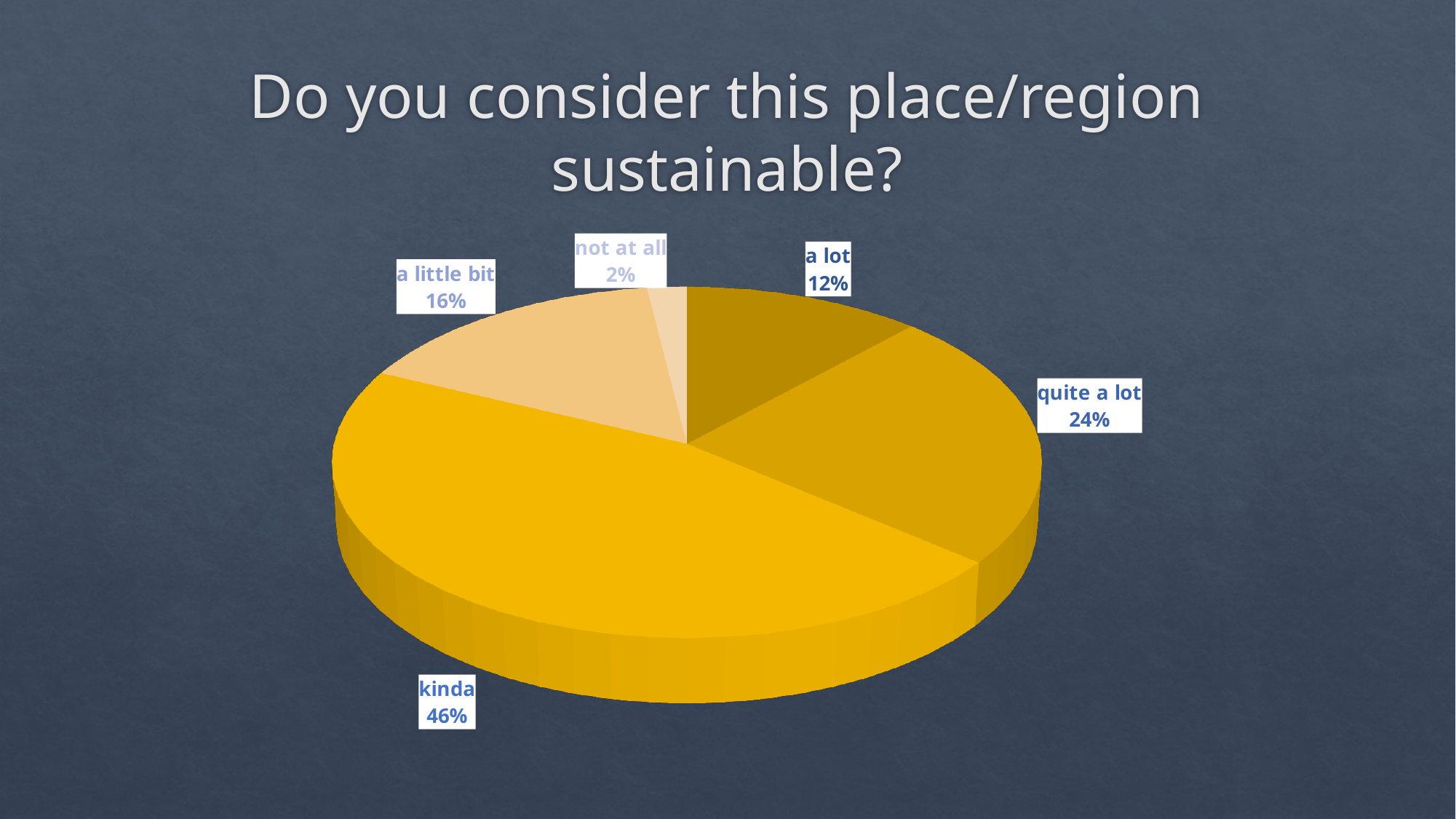
What is the difference in percentage points between "kinda" and "quite a lot"? 22 How many slices does the pie chart have? 5 Which response has the largest share of the pie? kinda What percentage of respondents answered "not at all"? 2% Which response has the smallest share of the pie? not at all What kind of chart is shown on the slide? pie chart What is the title of the chart? Do you consider this place/region sustainable? What percentage of respondents answered "a little bit"? 16% What percentage of respondents answered "a lot"? 12% What percentage of respondents answered "kinda"? 46% Which is larger, the share for "a little bit" or the share for "a lot"? a little bit What percentage of respondents answered "quite a lot"? 24%